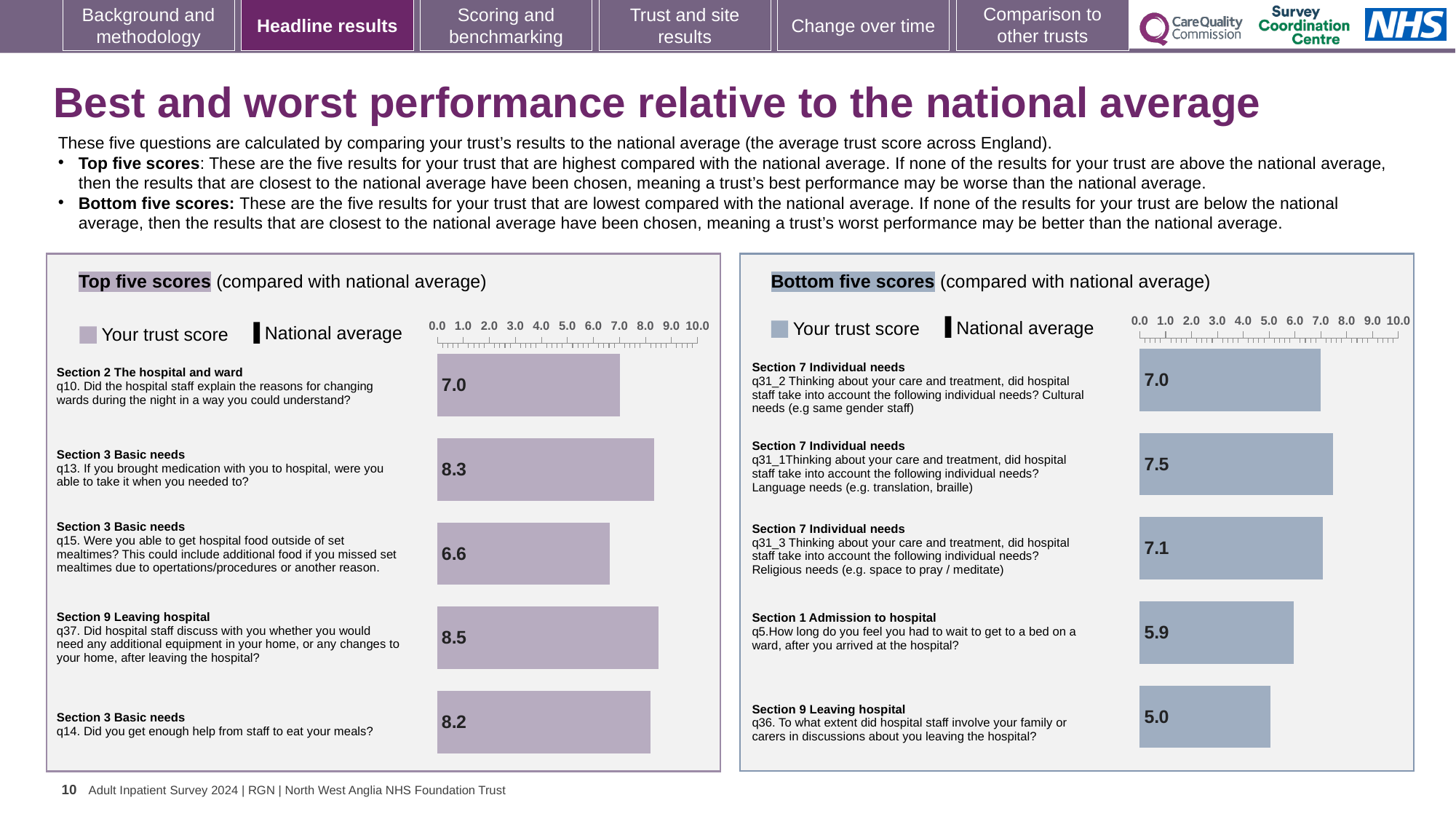
In the Top five scores chart, which question has the lowest trust score? q15 (hospital food outside of set mealtimes), 6.6 In the Bottom five scores chart, which question has the highest trust score? q31_1 (Language needs), 7.5 In the Top five scores chart, which question has the highest trust score? q37 (additional equipment or changes to your home after leaving hospital), 8.5 In the Bottom five scores chart, what is the trust score for q5 (How long do you feel you had to wait to get to a bed on a ward)? 5.9 In the Bottom five scores chart, which has the larger trust score: q31_2 (Cultural needs) or q31_3 (Religious needs)? q31_3 (Religious needs), 7.1 In the Bottom five scores chart, which question has the lowest trust score? q36 (involving family or carers in discussions about leaving hospital), 5.0 What type of chart is used in the Bottom five scores panel? Bar chart In the Bottom five scores chart, what is the trust score for q36 (To what extent did hospital staff involve your family or carers in discussions about you leaving the hospital?)? 5.0 In the Top five scores chart, what is the difference between the trust scores for q37 and q15? 1.9 In the Top five scores chart, what is the trust score for q13 (If you brought medication with you to hospital, were you able to take it when you needed to?)? 8.3 How many questions are shown as bars in the Top five scores chart? 5 How many entries does the legend of the Top five scores chart list? 2